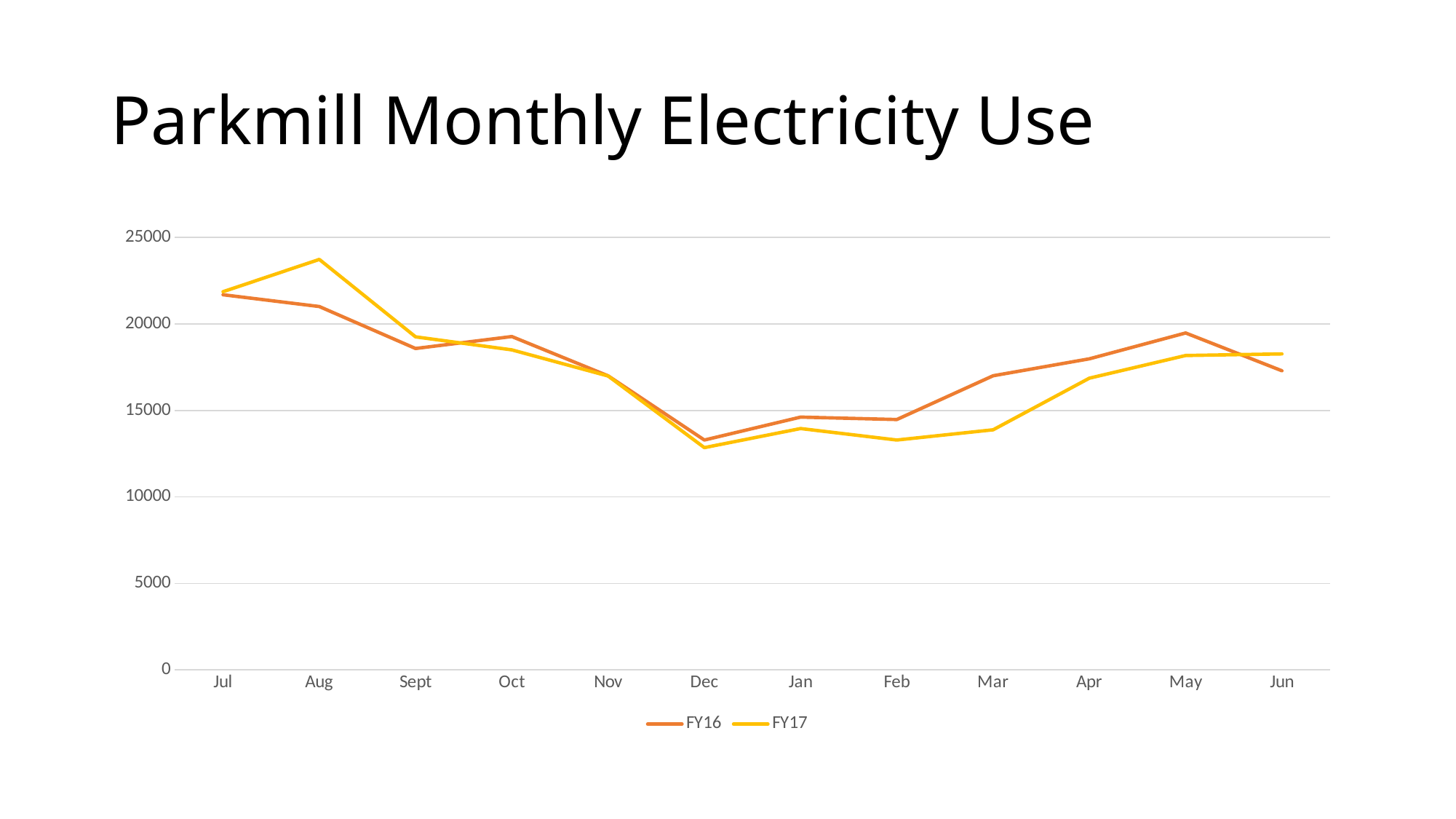
What kind of chart is shown on the slide? line chart In Aug, which series has the higher value, FY16 or FY17? FY17 Is the FY16 value for Dec greater or less than 15000? less In which month is the FY17 electricity use highest? Aug In which month is the FY17 electricity use lowest? Dec What is the title of the slide? Parkmill Monthly Electricity Use In which month is the FY16 electricity use lowest? Dec How many series does the legend list? 2 Is the FY17 value for Aug greater or less than 20000? greater In Mar, which series has the higher value, FY16 or FY17? FY16 How many months are plotted along the x axis? 12 Does the FY16 line rise or fall from Jul to Dec? fall